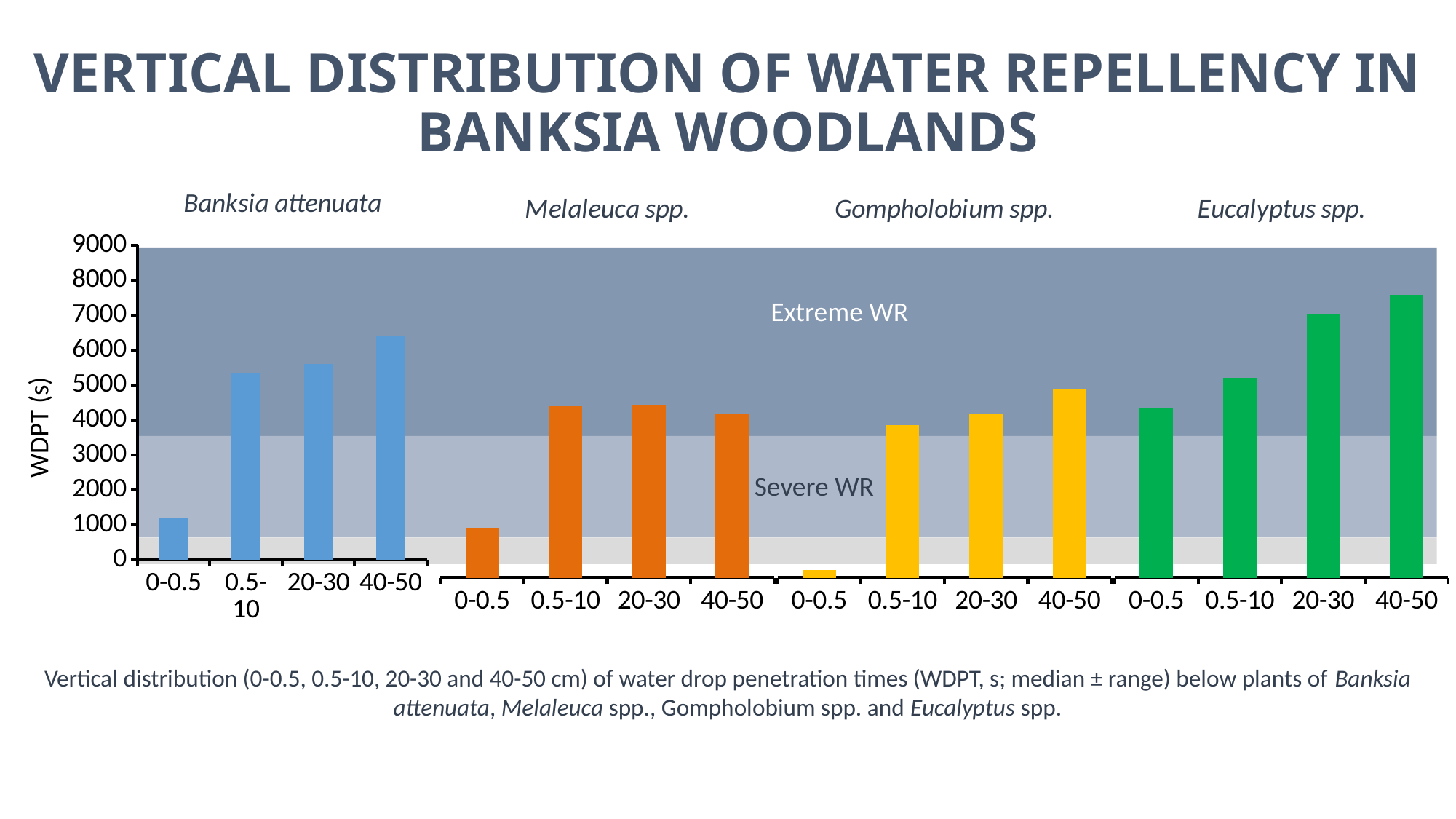
What kind of chart is used to show the WDPT values on this slide? bar chart In the Banksia attenuata chart, which depth has the lowest WDPT? 0-0.5 How many depth categories are shown in the Eucalyptus spp. chart? 4 In the Gompholobium spp. chart, is the value for 40-50 greater or less than 4000? greater In the Eucalyptus spp. chart, do the WDPT values rise or fall from 0-0.5 to 40-50? rise In the Gompholobium spp. chart, which depth has the highest WDPT? 40-50 In the Banksia attenuata chart, which depth has the highest WDPT? 40-50 In the Banksia attenuata chart, is the value for 0-0.5 greater or less than 2000? less In the Melaleuca spp. chart, is the value for 0-0.5 greater or less than 2000? less Which is larger: the 40-50 value in the Eucalyptus spp. chart or the 40-50 value in the Banksia attenuata chart? Eucalyptus spp. In the Melaleuca spp. chart, which depth has the lowest WDPT? 0-0.5